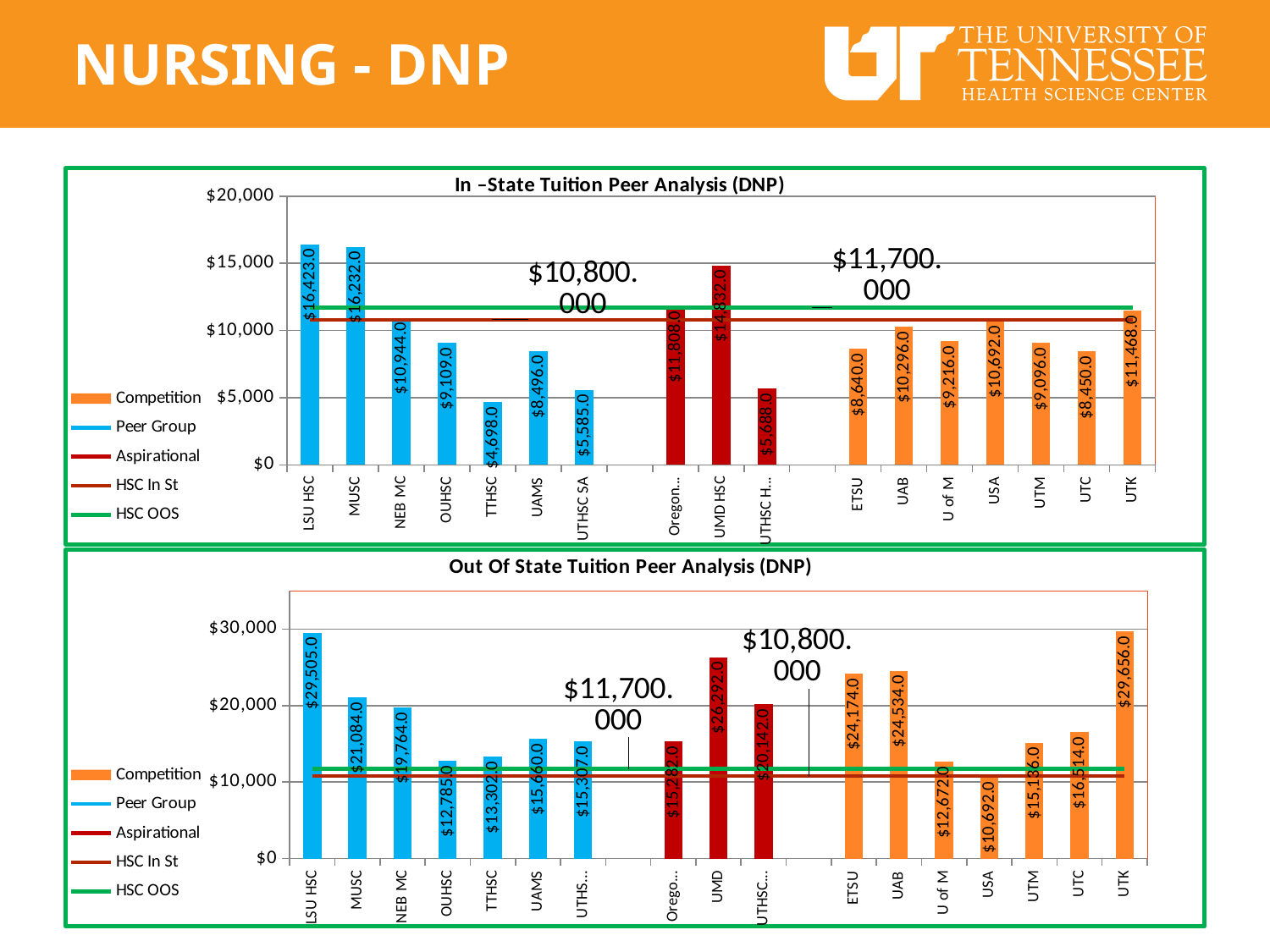
In the In-State Tuition Peer Analysis (DNP) chart, what is the value for NEB MC? $10,944.0 What kind of chart is the Out Of State Tuition Peer Analysis (DNP) chart? Bar chart In the Out Of State Tuition Peer Analysis (DNP) chart, what is the difference between MUSC and NEB MC? $1,320.0 In the In-State Tuition Peer Analysis (DNP) chart, which is larger, the value for USA or the value for UTM? USA How many institutions (bars) are shown in the Out Of State Tuition Peer Analysis (DNP) chart? 17 In the In-State Tuition Peer Analysis (DNP) chart, which institution has the lowest tuition? TTHSC In the Out Of State Tuition Peer Analysis (DNP) chart, which institution has the lowest tuition? USA How many series does the legend of the In-State Tuition Peer Analysis (DNP) chart list? 5 In the In-State Tuition Peer Analysis (DNP) chart, what is the value for UMD HSC? $14,832.0 In the In-State Tuition Peer Analysis (DNP) chart, what is the difference between UAB and ETSU? $1,656.0 In the Out Of State Tuition Peer Analysis (DNP) chart, what is the value for UMD? $26,292.0 In the Out Of State Tuition Peer Analysis (DNP) chart, what is the value for UAB? $24,534.0